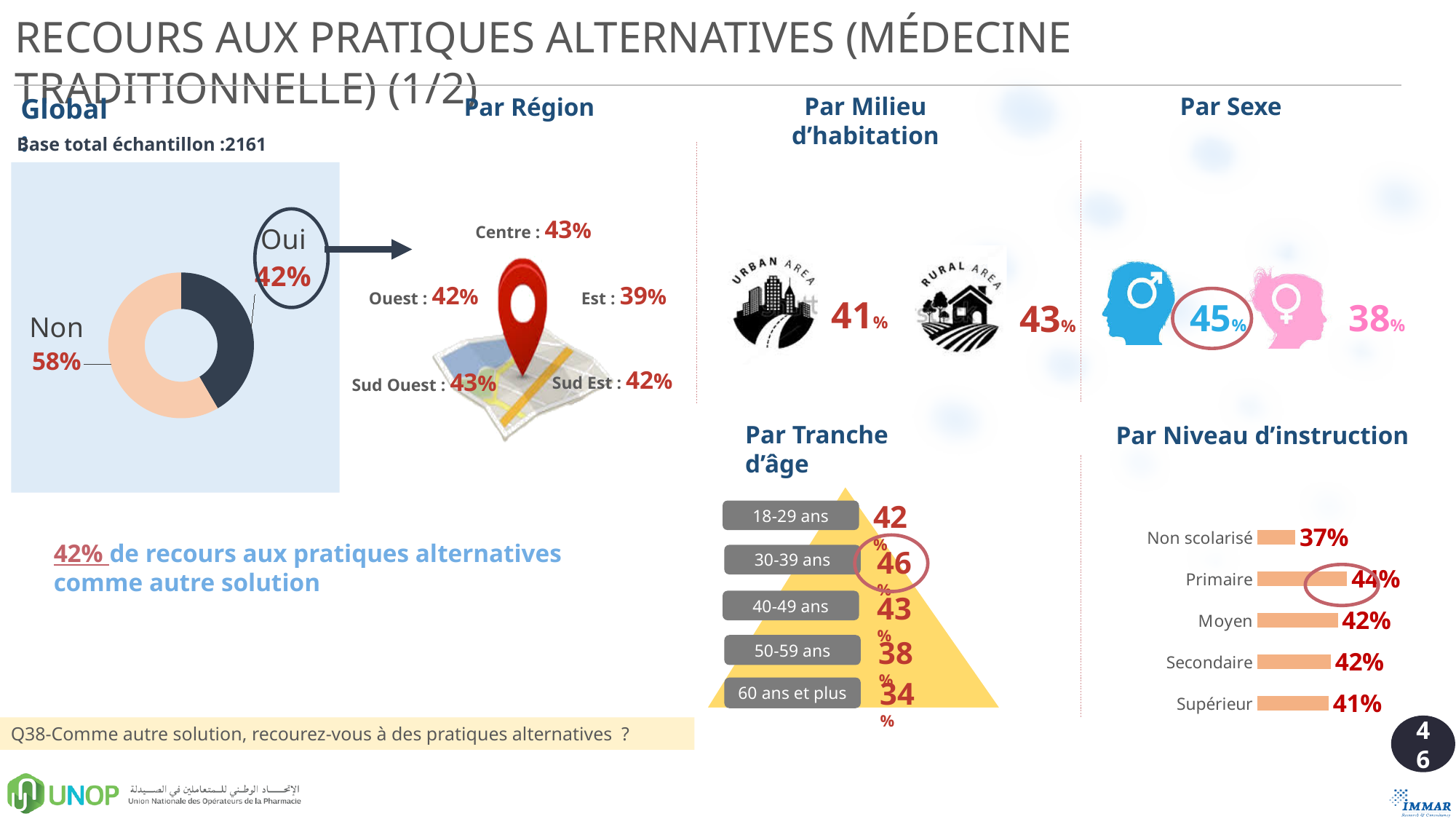
In the Par Niveau d'instruction chart, what is the value for Primaire? 44% How many categories are shown in the Par Niveau d'instruction chart? 5 In the Global donut chart, what is the value for Oui? 42% What kind of chart is the Par Niveau d'instruction chart? Bar chart What kind of chart is the Global chart? Donut (pie) chart In the Par Niveau d'instruction chart, which category has the lowest value? Non scolarisé In the Par Niveau d'instruction chart, what is the value for Non scolarisé? 37% In the Global donut chart, what is the difference between Non and Oui? 16% In the Par Niveau d'instruction chart, which category has the highest value? Primaire In the Par Niveau d'instruction chart, what is the difference between Primaire and Supérieur? 3% In the Global donut chart, what is the value for Non? 58% In the Global donut chart, which slice is larger, Oui or Non? Non